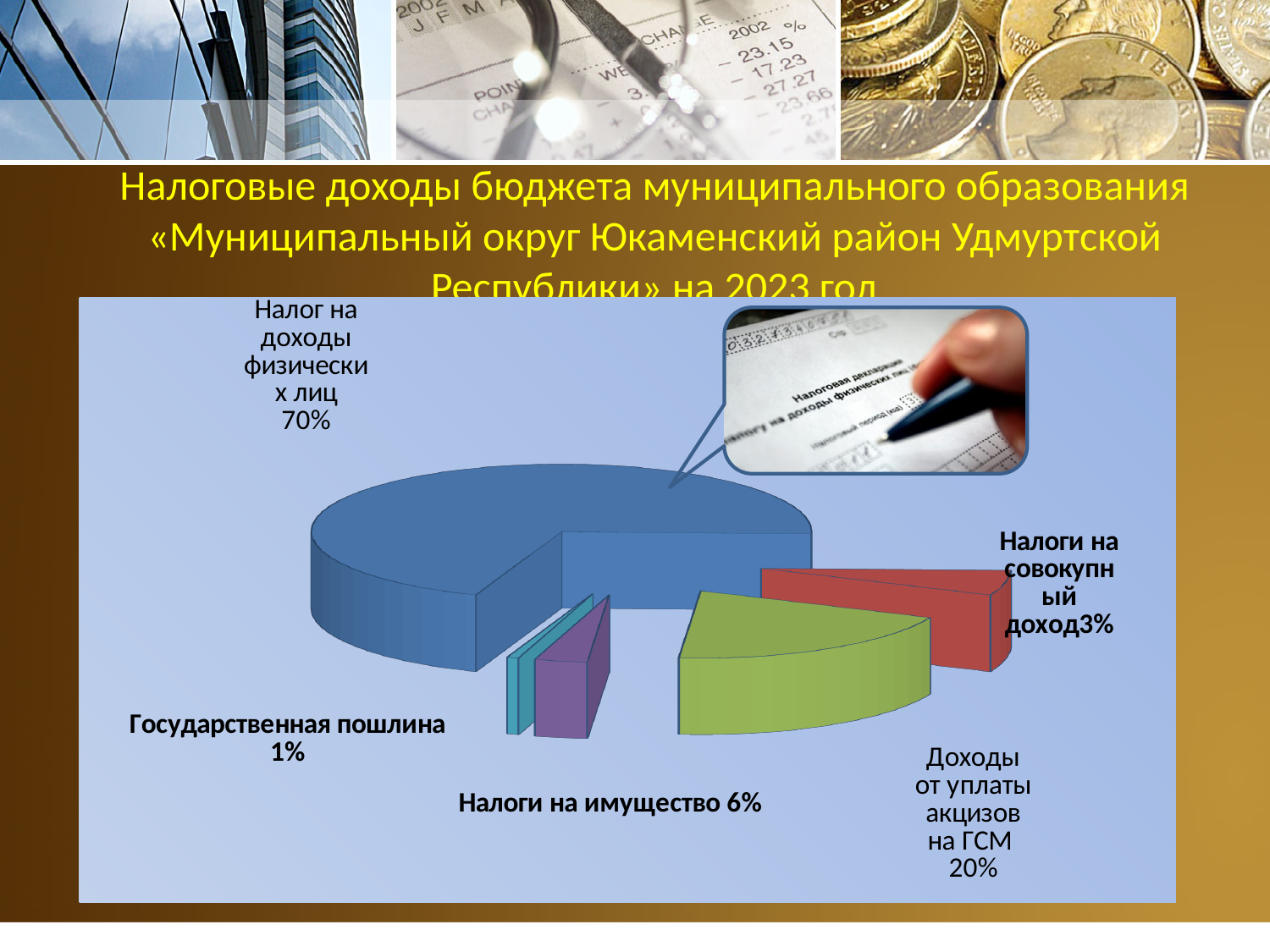
What share of the pie does "Доходы от уплаты акцизов на ГСМ" have? 20% Which is larger: the share for "Налоги на имущество" or the share for "Налоги на совокупный доход"? Налоги на имущество What is the difference in percentage points between "Налог на доходы физических лиц" and "Доходы от уплаты акцизов на ГСМ"? 50 percentage points Which category has the smallest slice of the pie? Государственная пошлина What colour is the slice for "Налог на доходы физических лиц"? Blue Which category has the largest slice of the pie? Налог на доходы физических лиц What share of the pie does "Налог на доходы физических лиц" have? 70% What share of the pie does "Государственная пошлина" have? 1% What share of the pie does "Налоги на совокупный доход" have? 3% What share of the pie does "Налоги на имущество" have? 6% How many slices does the pie chart have? 5 What kind of chart is shown on the slide? Pie chart